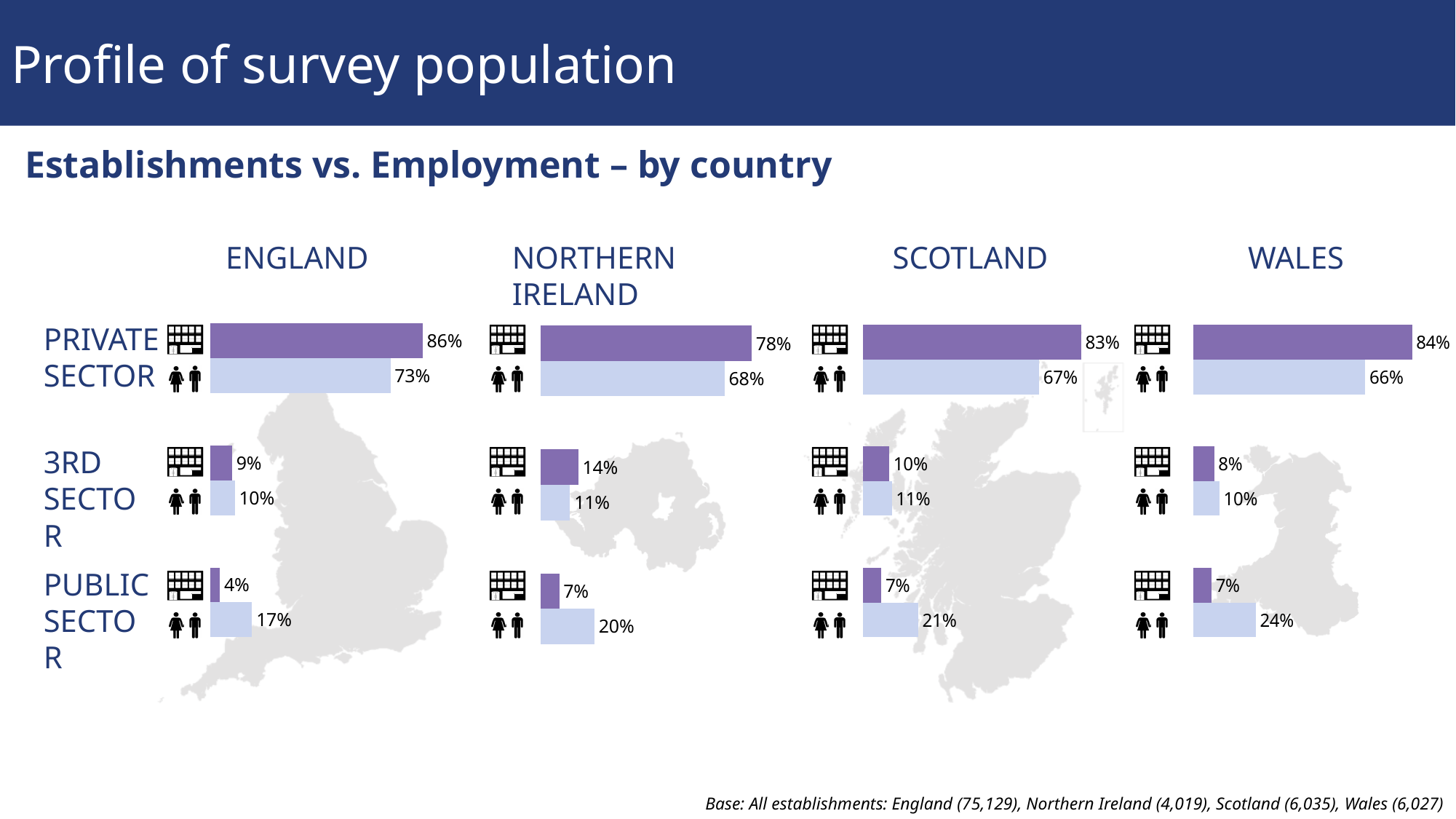
In the England chart, what is the establishments value (building icon) for the private sector? 86% In the Wales chart, which sector has the lowest establishments value (building icon)? Public sector In the Northern Ireland chart, what is the employment value (people icon) for the public sector? 20% How many sectors are shown in each country chart? 3 In the England chart, which sector has the highest employment value (people icon)? Private sector In the Scotland chart, what is the difference between the private sector establishments value (83%) and the private sector employment value (67%)? 16% In the Wales chart, what is the employment value (people icon) for the private sector? 66% In the Northern Ireland chart, which is larger for the 3rd sector: the establishments value or the employment value? Establishments value How many countries have their own chart on the slide? 4 In the England chart, what is the difference between the public sector employment value (17%) and the public sector establishments value (4%)? 13% What type of chart is used for each country on the slide? Bar chart In the Scotland chart, what is the establishments value (building icon) for the 3rd sector? 10%